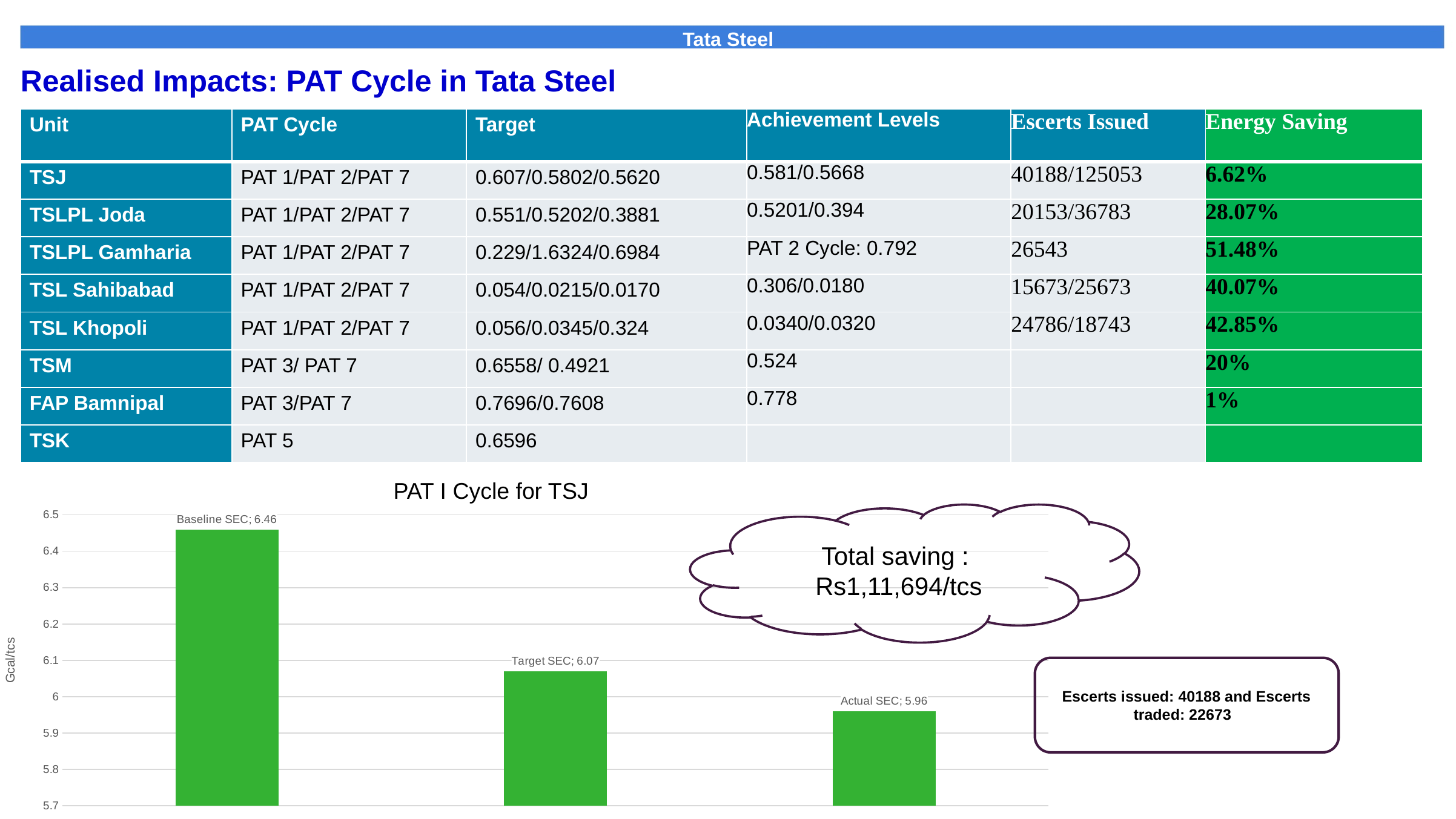
Which is larger in the chart, Target SEC or Actual SEC? Target SEC What is the difference between Baseline SEC and Actual SEC in the chart? 0.5 What type of chart is shown on the slide? bar chart What is the value of Baseline SEC in the chart? 6.46 What is the value of Target SEC in the chart? 6.07 Which bar in the chart has the highest value? Baseline SEC Which bar in the chart has the lowest value? Actual SEC What is the value of Actual SEC in the chart? 5.96 What is the title of the chart on the slide? PAT I Cycle for TSJ What is the difference between Target SEC and Actual SEC in the chart? 0.11 How many bars are plotted in the chart? 3 Do the values in the chart rise or fall from left to right? fall